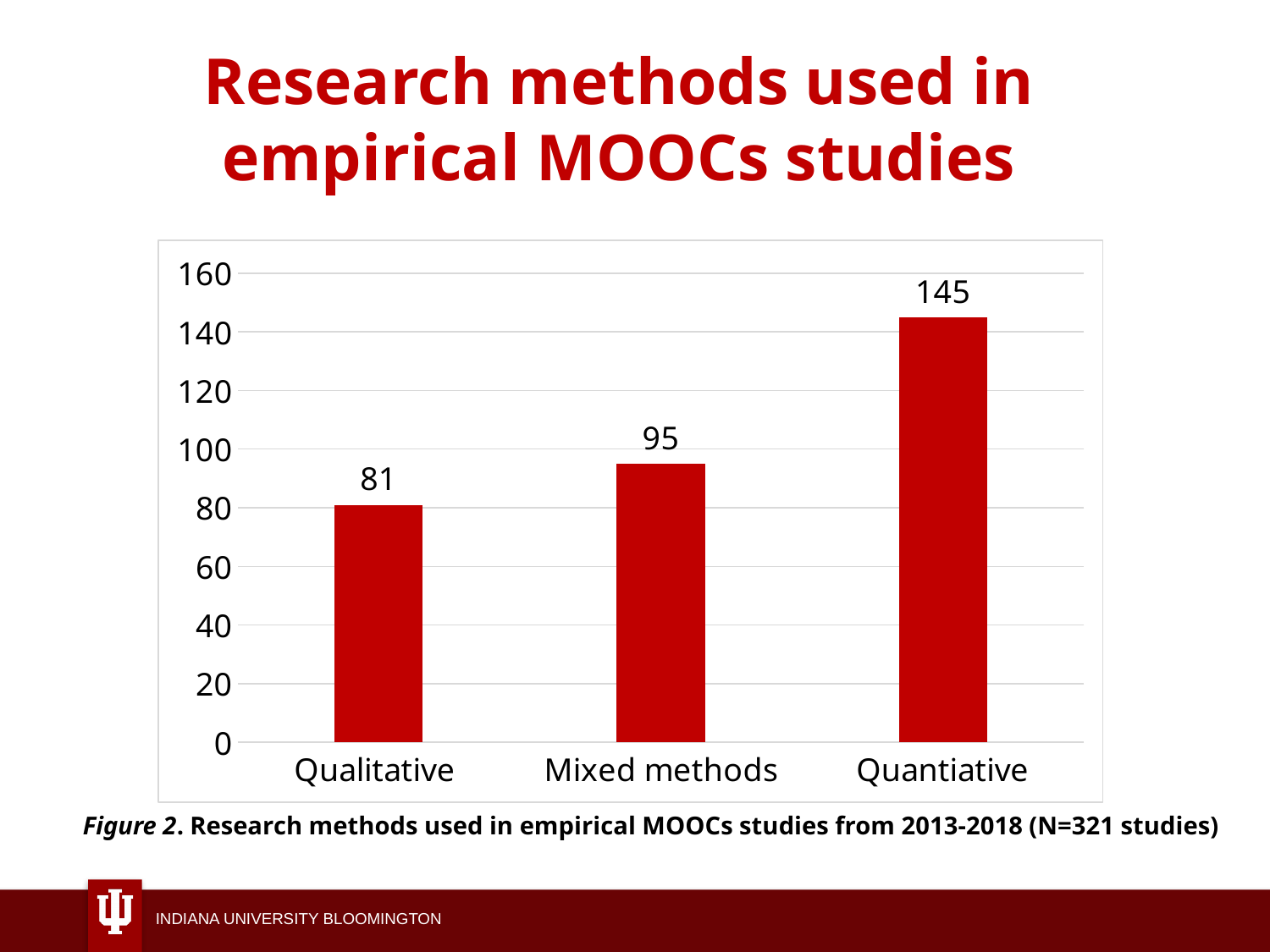
What kind of chart is shown on the slide? bar chart Which research method has the lowest value? Qualitative What is the value for Quantiative? 145 How many categories are shown on the x axis? 3 Is the value for Quantiative greater or less than 140? greater Do the values rise or fall from left to right along the x axis? rise Which is larger, the value for Mixed methods or the value for Qualitative? Mixed methods What is the difference between the values for Quantiative and Qualitative? 64 What is the value for Mixed methods? 95 Which research method has the highest value? Quantiative What is the value for Qualitative? 81 What is the difference between the values for Mixed methods and Qualitative? 14